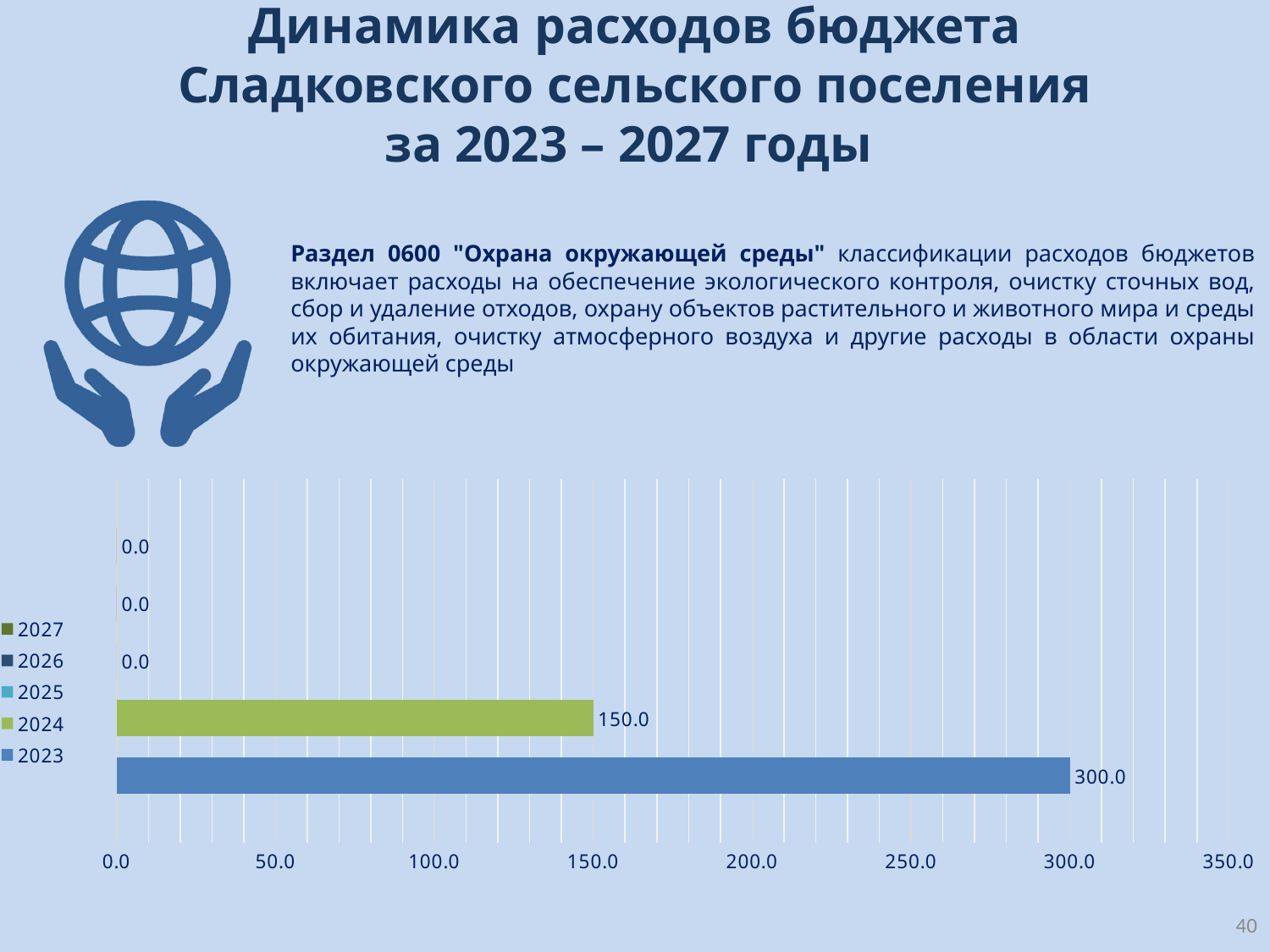
Какое значение показано для 2024 года на диаграмме? 150.0 Сколько рядов (годов) перечислено в легенде диаграммы? 5 На сколько значение 2023 года больше значения 2024 года? 150.0 Какое значение больше: за 2023 год или за 2024 год? 2023 Какое значение показано для 2027 года на диаграмме? 0.0 Какой год имеет наибольшее значение на диаграмме? 2023 Значение для 2023 года больше или меньше 250.0? больше Значение для 2024 года больше или меньше 200.0? меньше Какого типа эта диаграмма? Столбчатая (линейчатая) диаграмма Какое значение показано для 2025 года на диаграмме? 0.0 Какое максимальное значение показано на горизонтальной оси диаграммы? 350.0 Какое значение показано для 2023 года на диаграмме? 300.0